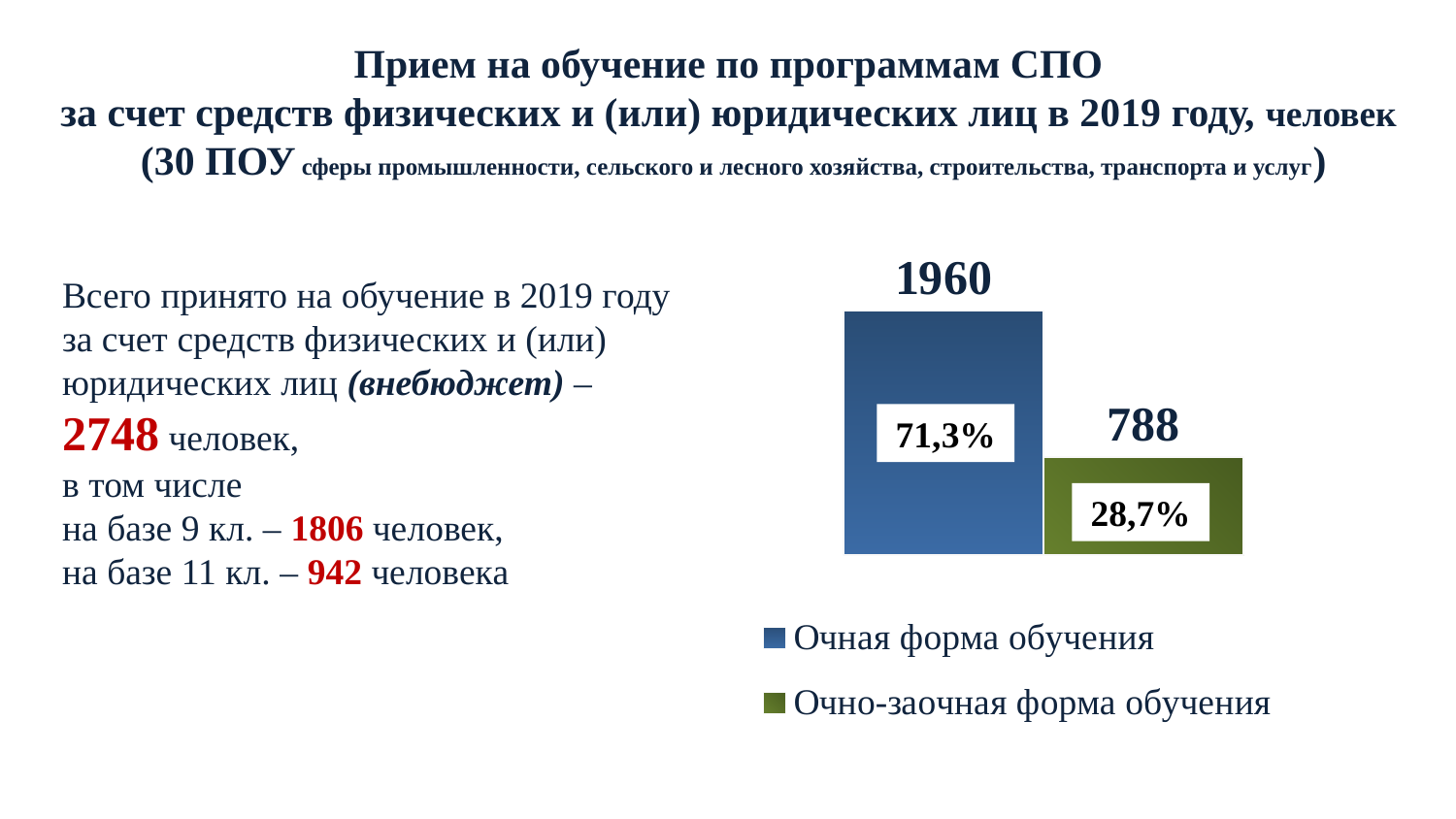
Which is larger: the value for Очная форма обучения or for Очно-заочная форма обучения? Очная форма обучения What percentage is shown on the bar for Очно-заочная форма обучения? 28,7% What is the value for Очная форма обучения? 1960 What colour is the bar for Очно-заочная форма обучения? green What is the difference between the values for Очная форма обучения and Очно-заочная форма обучения? 1172 How many series does the legend list? 2 What percentage is shown on the bar for Очная форма обучения? 71,3% Which form of study has the highest value? Очная форма обучения What is the value for Очно-заочная форма обучения? 788 Which form of study has the lowest value? Очно-заочная форма обучения What is the total of the two bars in the chart? 2748 What kind of chart is shown on the slide? bar chart